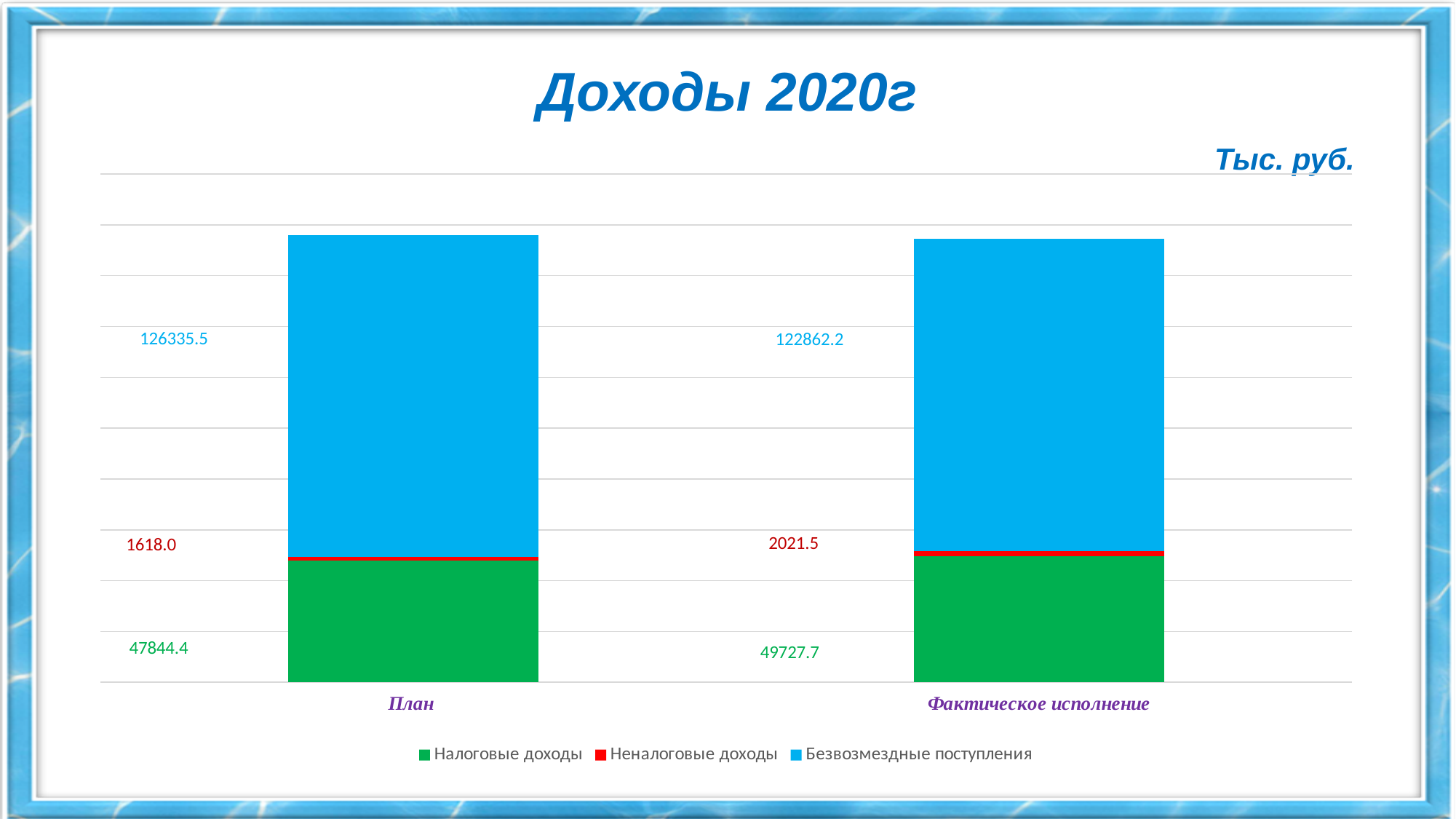
What unit is indicated for the chart values? Тыс. руб. What is the value of Неналоговые доходы for План? 1618.0 What is the difference between Безвозмездные поступления for План and for Фактическое исполнение? 3473.3 How many series does the legend list? 3 Which series has the smallest value in the План bar? Неналоговые доходы What is the value of Неналоговые доходы for Фактическое исполнение? 2021.5 What is the value of Безвозмездные поступления for Фактическое исполнение? 122862.2 Is Налоговые доходы larger for План or for Фактическое исполнение? Фактическое исполнение What is the value of Налоговые доходы for План? 47844.4 What kind of chart is shown on the slide? Stacked bar chart What is the total of the План stacked bar? 175797.9 Which series has the largest value in the Фактическое исполнение bar? Безвозмездные поступления